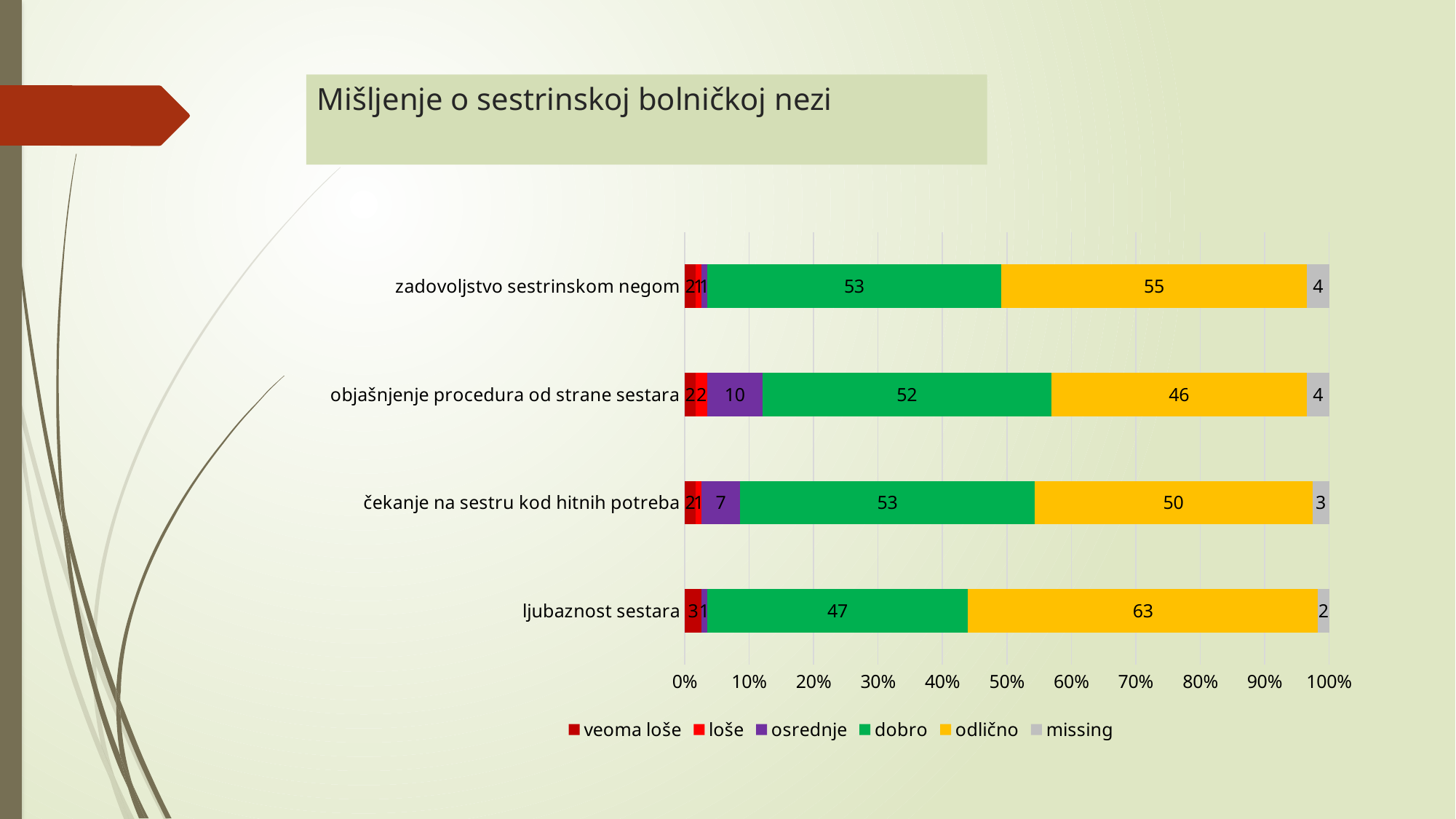
How many series does the legend list? 6 What is the 'dobro' value for 'objašnjenje procedura od strane sestara'? 52 What is the difference between the 'odlično' values for 'ljubaznost sestara' and 'zadovoljstvo sestrinskom negom'? 8 Which category has the highest 'odlično' value? ljubaznost sestara What is the title of the chart slide? Mišljenje o sestrinskoj bolničkoj nezi What is the 'odlično' value for 'ljubaznost sestara'? 63 What is the 'missing' value for 'zadovoljstvo sestrinskom negom'? 4 What type of chart is shown on the slide? stacked bar chart What is the 'osrednje' value for 'čekanje na sestru kod hitnih potreba'? 7 How many categories are shown on the chart? 4 Which category has the lowest 'dobro' value? ljubaznost sestara For 'objašnjenje procedura od strane sestara', which is larger: the 'dobro' value or the 'odlično' value? dobro